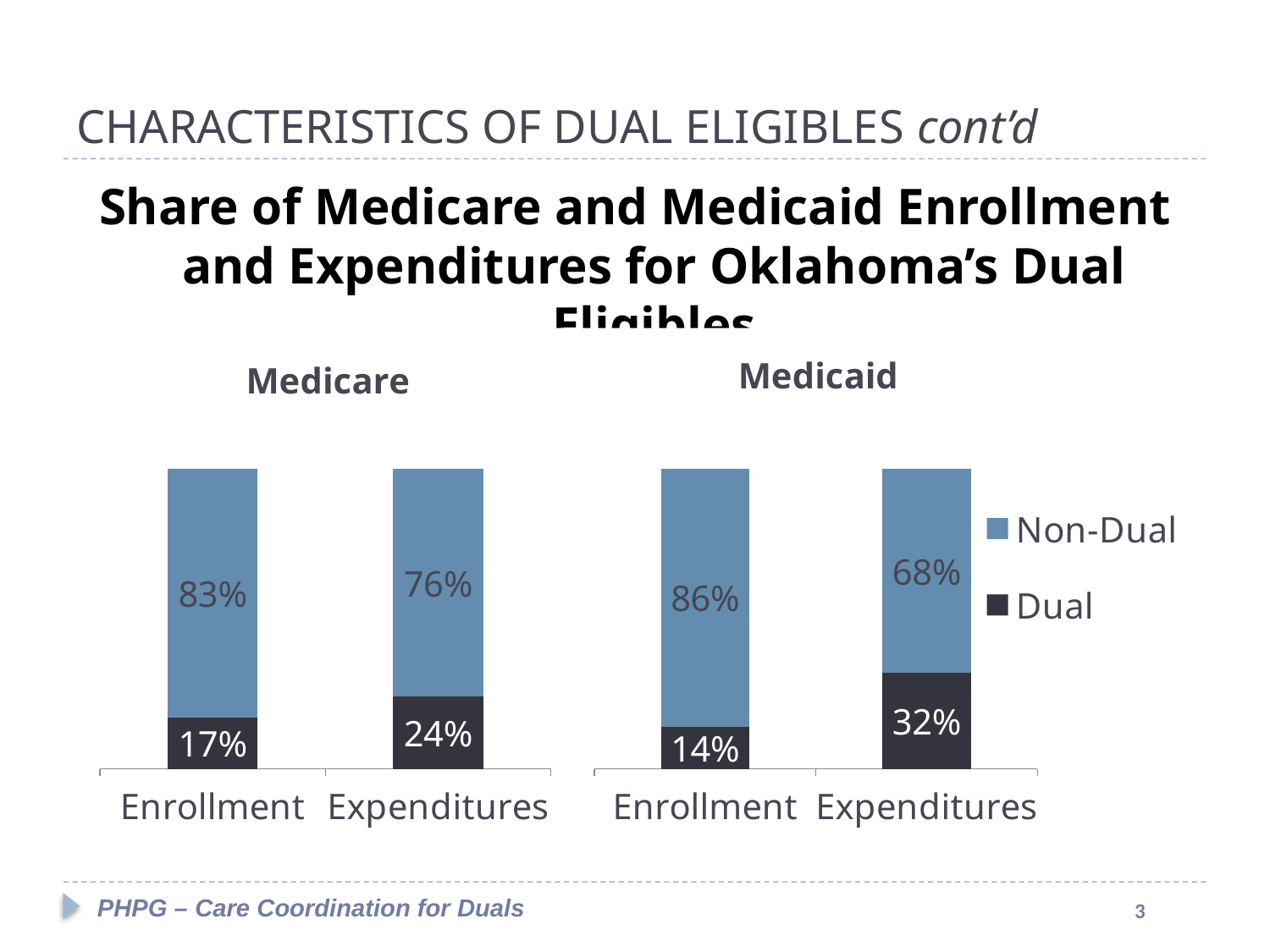
In the Medicaid chart, what is the difference between the Dual share of Expenditures and the Dual share of Enrollment? 18% How many categories are shown on the x axis of the Medicaid chart? 2 In the Medicare chart, which category has the larger Dual share, Enrollment or Expenditures? Expenditures How many series does the legend list? 2 In the Medicaid chart, which category has the higher Non-Dual share? Enrollment What kind of chart is the Medicare chart? Stacked bar chart In the Medicare chart, what is the Non-Dual share of Expenditures? 76% In the Medicare chart, what is the difference between the Non-Dual and Dual shares of Enrollment? 66% In the Medicaid chart, what is the total of the Enrollment stacked bar? 100% In the Medicaid chart, what is the Non-Dual share of Enrollment? 86% In the Medicaid chart, what is the Dual share of Expenditures? 32% In the Medicare chart, what is the Dual share of Enrollment? 17%